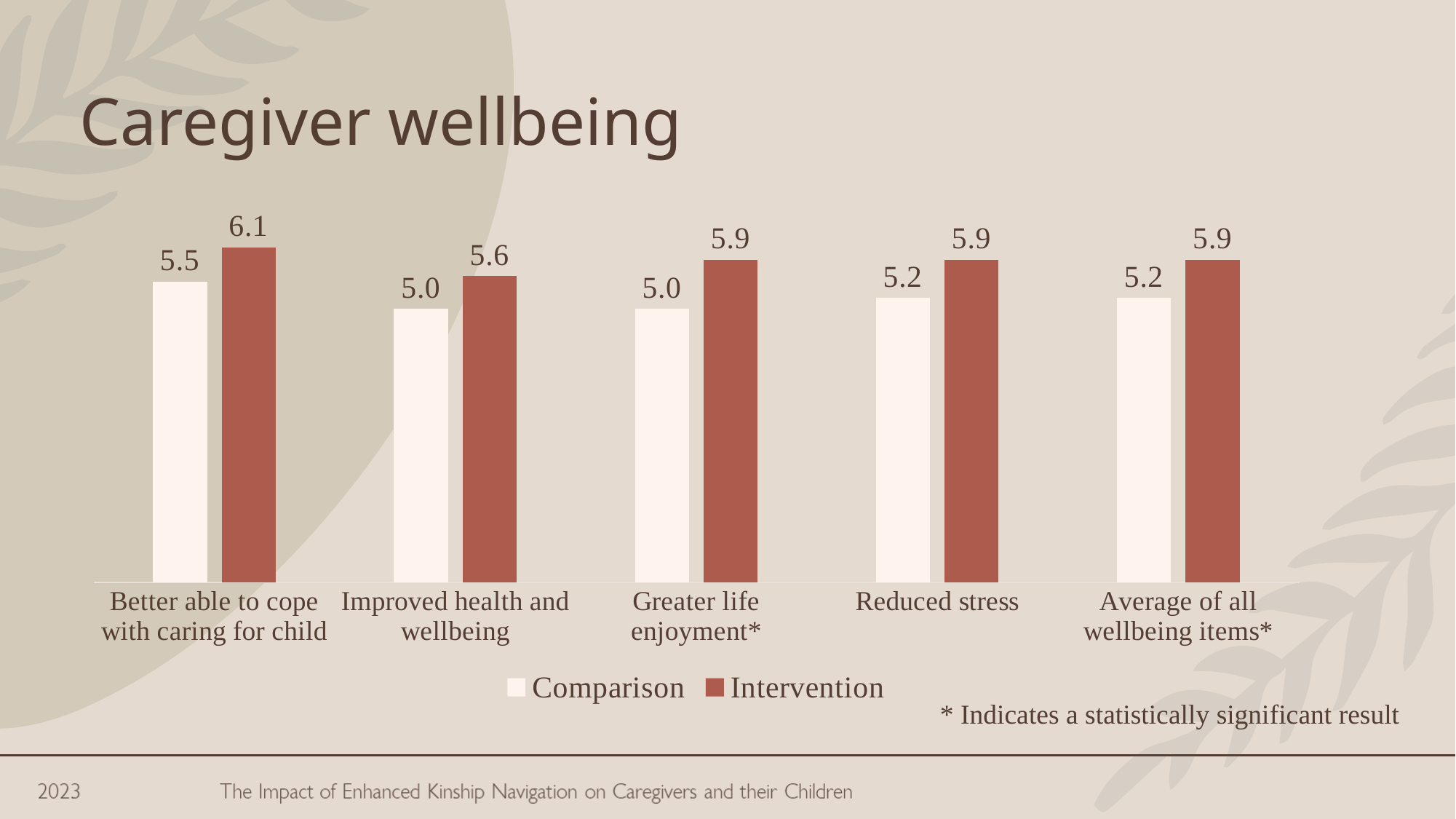
How many categories are shown on the x axis? 5 What kind of chart is shown on the slide? Bar chart How many series does the legend list? 2 Which category has the highest Intervention value? Better able to cope with caring for child What is the Intervention value for "Better able to cope with caring for child"? 6.1 What is the difference between the Intervention and Comparison values for "Improved health and wellbeing"? 0.6 What is the Comparison value for "Improved health and wellbeing"? 5.0 What is the difference between the Intervention and Comparison values for "Greater life enjoyment*"? 0.9 What is the Comparison value for "Reduced stress"? 5.2 For "Reduced stress", which is larger, the Comparison value or the Intervention value? Intervention Which category has the highest Comparison value? Better able to cope with caring for child What is the Intervention value for "Average of all wellbeing items*"? 5.9